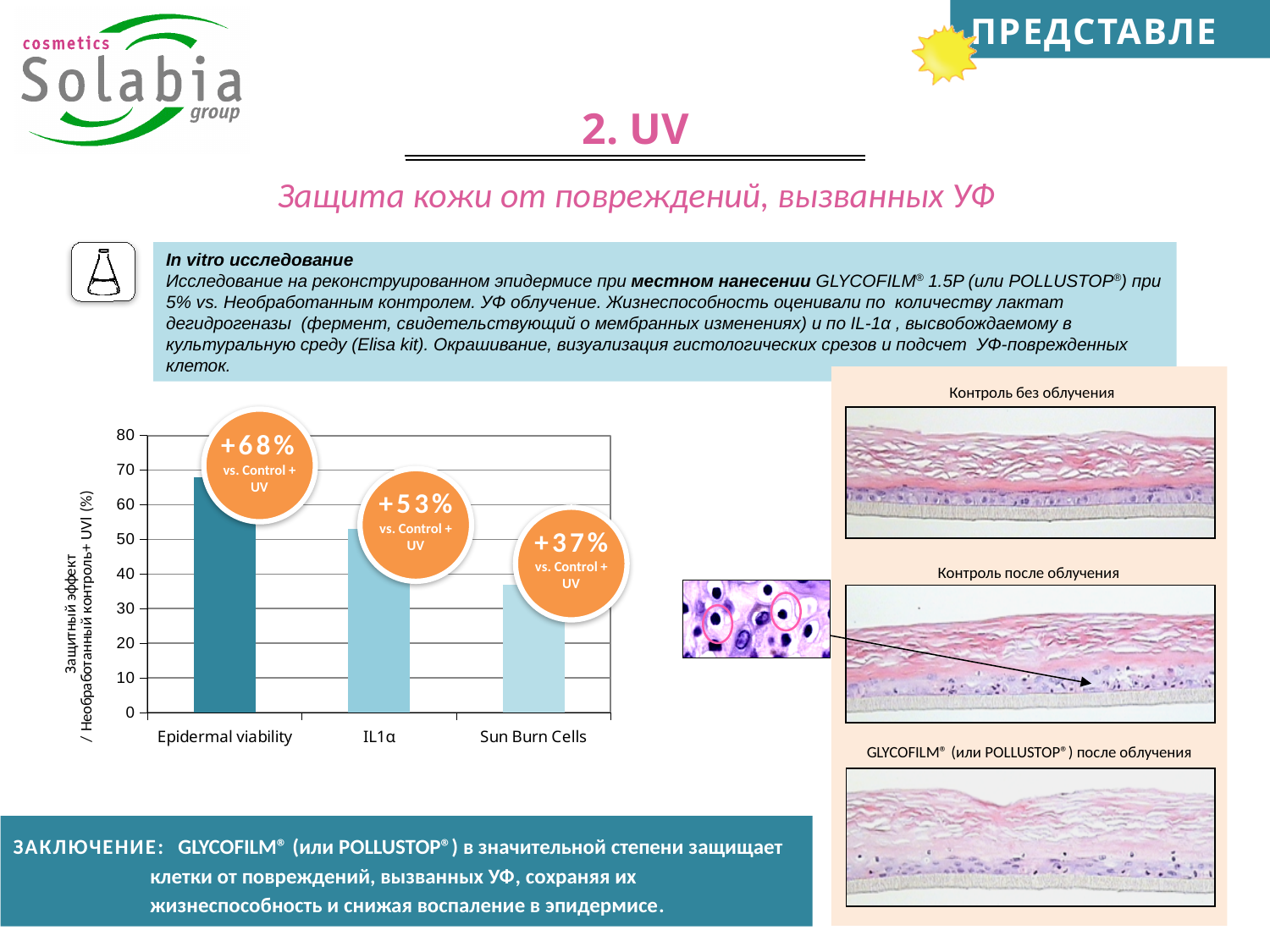
What percentage is shown in the callout above the Epidermal viability bar? +68% What kind of chart is shown on the slide? bar chart Which category has the lowest bar in the chart? Sun Burn Cells What percentage is shown in the callout above the Sun Burn Cells bar? +37% Do the bar values rise or fall from left to right along the x axis? fall Which bar is taller, IL1α or Sun Burn Cells? IL1α Is the value for Epidermal viability greater or less than 60? greater How many categories are shown on the x axis of the bar chart? 3 What is the maximum value shown on the y axis of the chart? 80 Which category has the highest bar in the chart? Epidermal viability What percentage is shown in the callout above the IL1α bar? +53% Is the value for Sun Burn Cells greater or less than 40? less